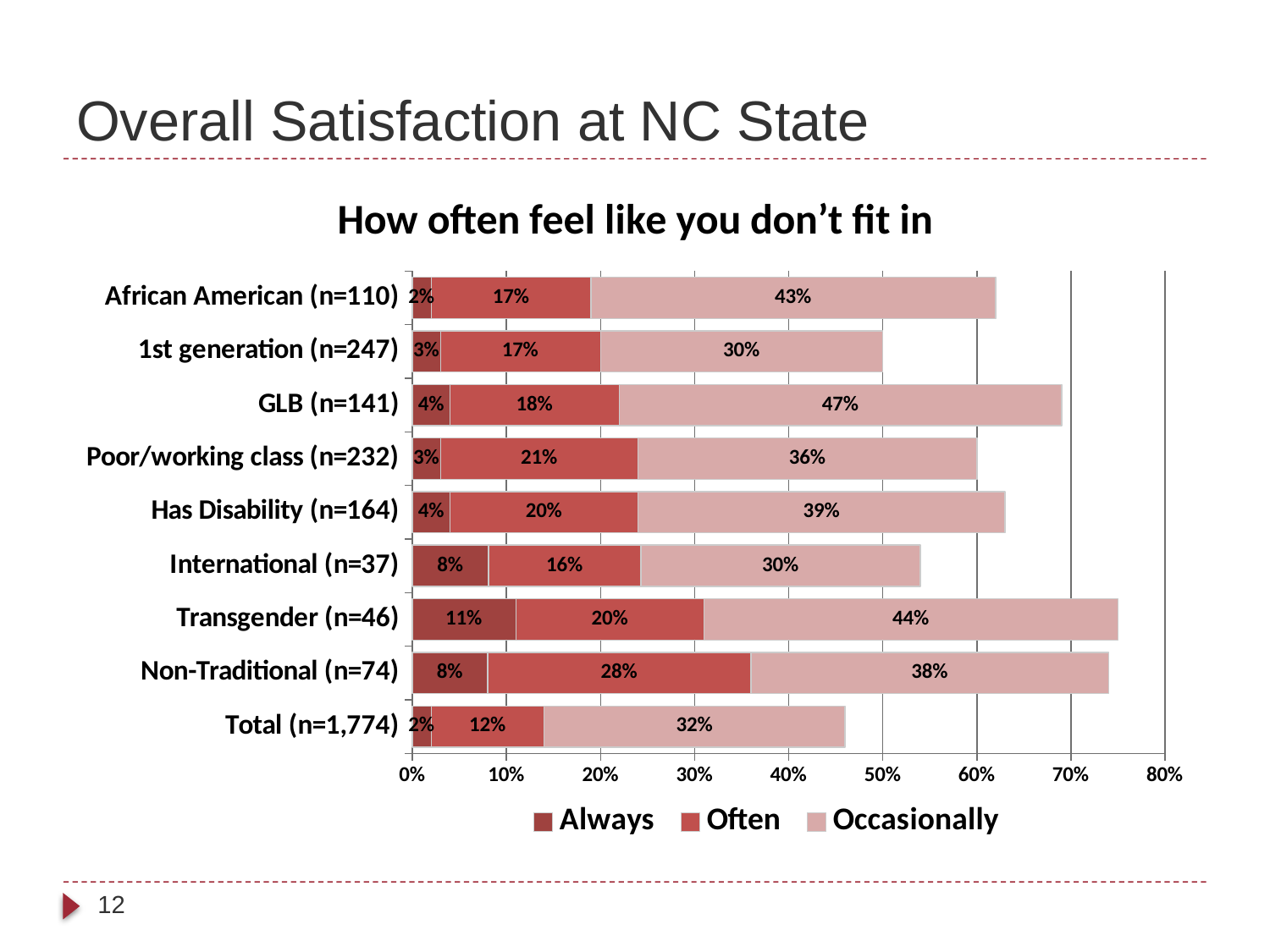
What is the total of the stacked bar for Total (n=1,774)? 46% How many categories are shown on the chart? 9 Which is larger, the 'Often' value for Poor/working class (n=232) or for International (n=37)? Poor/working class (n=232) What is the total of the stacked bar for Transgender (n=46)? 75% What kind of chart is shown on the slide? Stacked bar chart Which category has the lowest 'Often' value? Total (n=1,774) What is the 'Always' value for Transgender (n=46)? 11% Which category has the highest 'Always' value? Transgender (n=46) What is the 'Often' value for Non-Traditional (n=74)? 28% What is the 'Occasionally' value for GLB (n=141)? 47% What is the difference between the 'Occasionally' values for GLB (n=141) and 1st generation (n=247)? 17% How many series does the legend list? 3